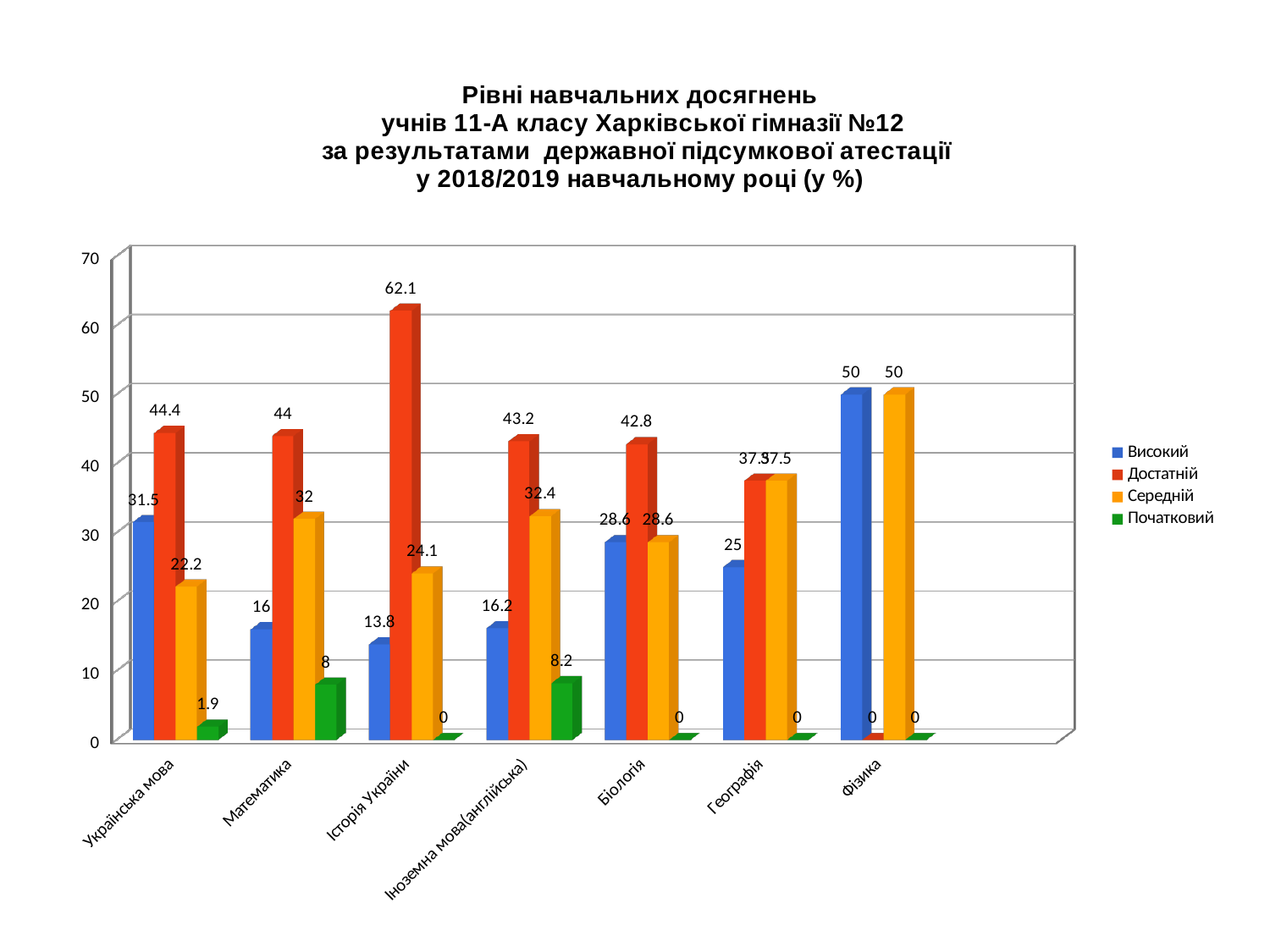
Which series is shown in green in the legend? Початковий How many categories are shown on the x axis? 7 What kind of chart is shown on the slide? bar chart What is the value of Середній for Іноземна мова(англійська)? 32.4 What is the difference between the Достатній and Середній values for Українська мова? 22.2 What is the value of Початковий for Математика? 8 What is the value of Високий for Українська мова? 31.5 Which is larger: the Високий value for Біологія or the Високий value for Географія? Біологія What is the value of Достатній for Історія України? 62.1 Which category has the highest Достатній value? Історія України How many series does the legend list? 4 Which category has the highest Високий value? Фізика